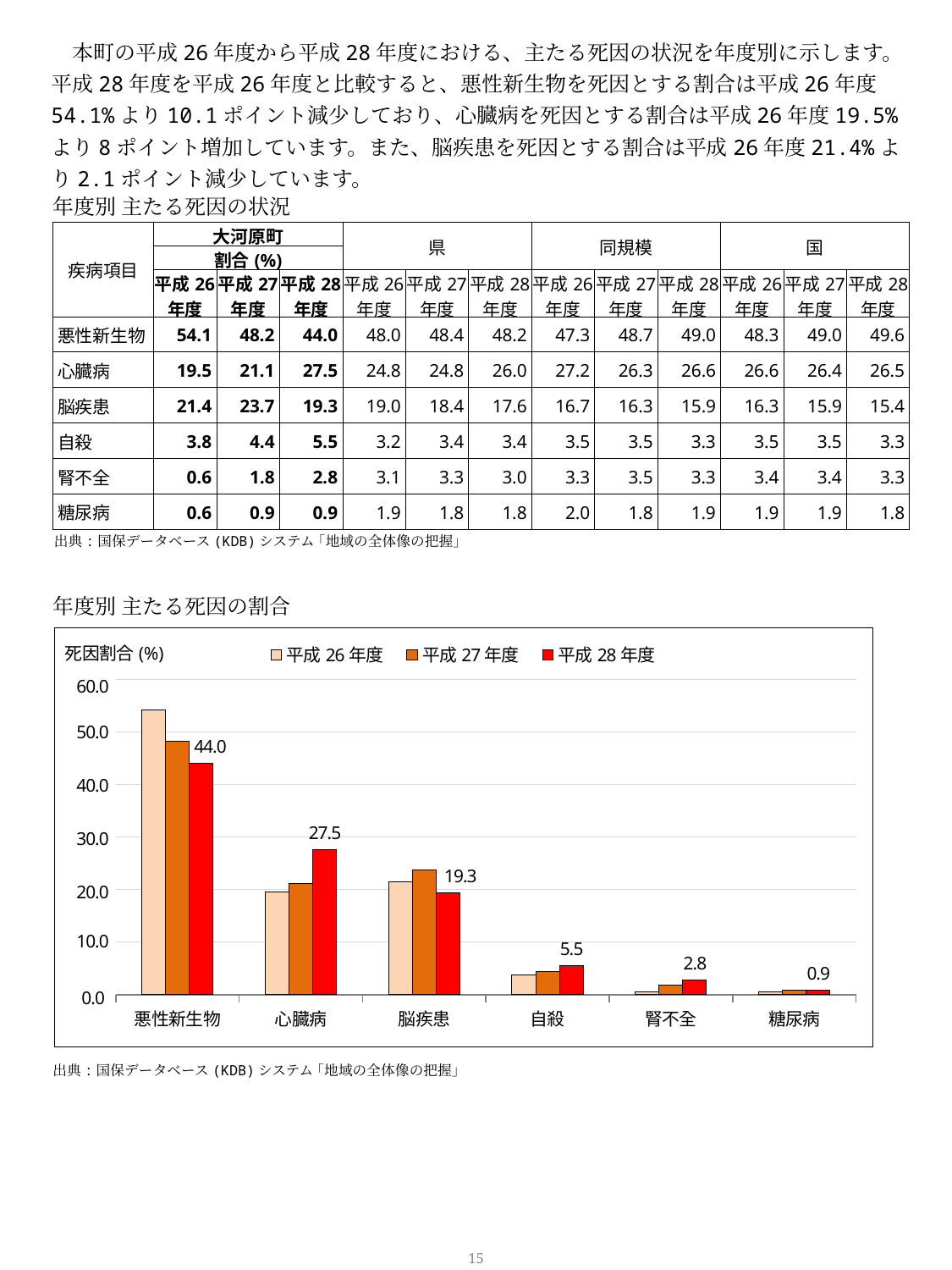
In the chart, which category has the highest value for 平成28年度? 悪性新生物 In the chart, what is the value for 自殺 in 平成28年度? 5.5 How many cause-of-death categories are shown on the x axis of the chart? 6 In the chart, what is the value for 心臓病 in 平成28年度? 27.5 In the chart, what is the value for 悪性新生物 in 平成28年度? 44.0 In the chart, which category has the lowest value for 平成28年度? 糖尿病 In the chart, what is the difference between the 平成28年度 values for 悪性新生物 and 心臓病? 16.5 In the chart, which is larger for 脳疾患: the 平成27年度 value or the 平成28年度 value? 平成27年度 How many series does the legend of the chart list? 3 What is the label shown at the top left of the chart's plot area? 死因割合 (%) What kind of chart is shown under the title 年度別 主たる死因の割合? bar chart In the chart, is the 平成26年度 value for 悪性新生物 greater or less than 50.0? greater